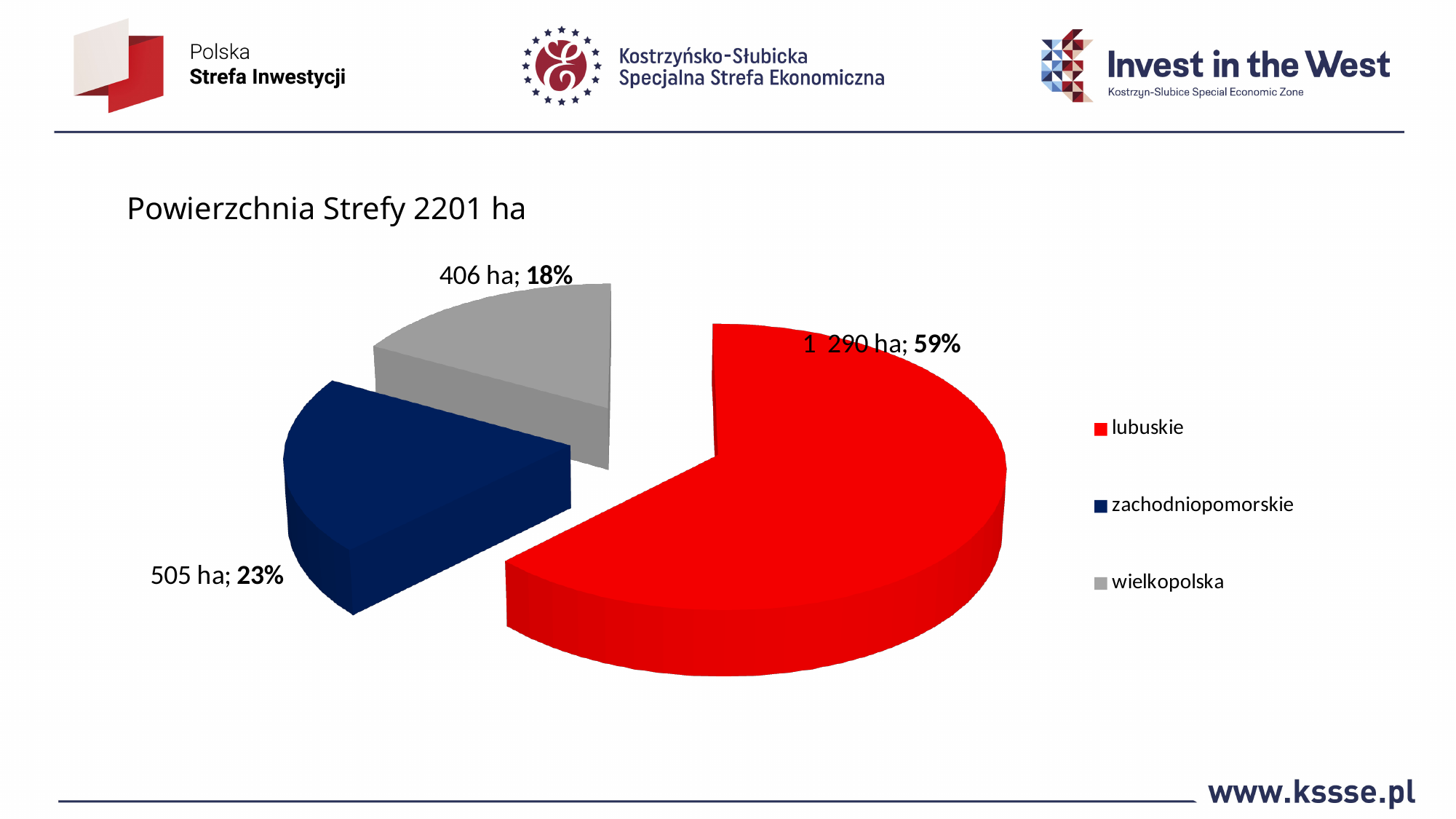
How many slices does the pie chart have? 3 What is the difference in area between lubuskie and zachodniopomorskie? 785 ha What kind of chart is shown on the slide? pie chart What percentage share of the pie does wielkopolska have? 18% What area is shown for wielkopolska? 406 ha Which is larger, the area for zachodniopomorskie or for wielkopolska? zachodniopomorskie What percentage share of the pie does lubuskie have? 59% What area is shown for lubuskie? 1 290 ha What is the title of the chart? Powierzchnia Strefy 2201 ha Which region has the largest slice of the pie? lubuskie Which region has the smallest slice of the pie? wielkopolska What area is shown for zachodniopomorskie? 505 ha